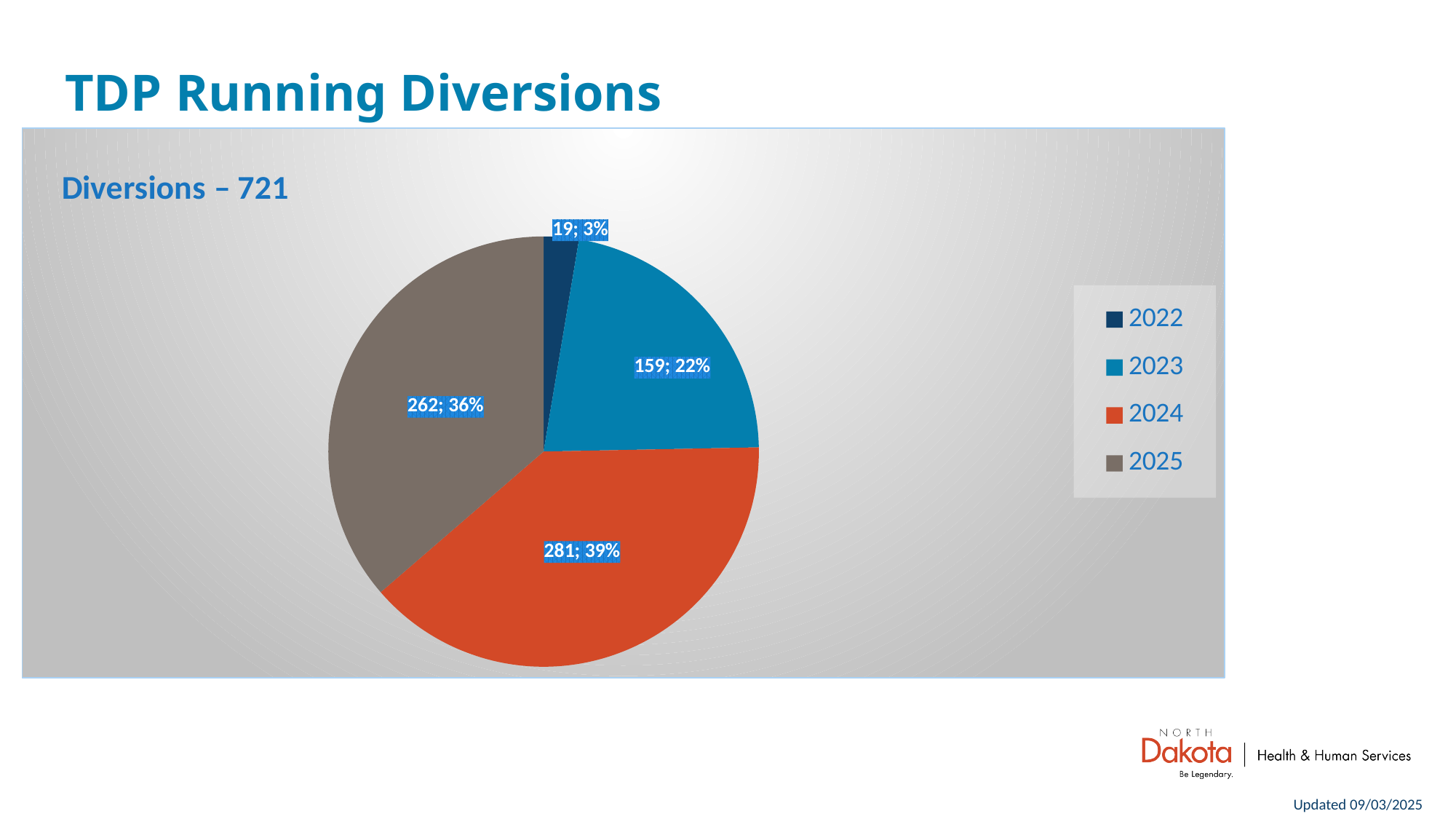
What kind of chart is shown on the slide? pie chart Which year has the smallest slice of the pie? 2022 How many diversions are shown for 2023? 159 Which year has more diversions, 2023 or 2025? 2025 How many diversions are shown for 2022? 19 How many years does the legend list? 4 How many diversions are shown for 2024? 281 What total number of diversions is stated above the chart? 721 What share of the pie does 2025 represent? 36% What is the difference in diversions between 2024 and 2025? 19 What share of the pie does 2022 represent? 3% Which year has the largest slice of the pie? 2024